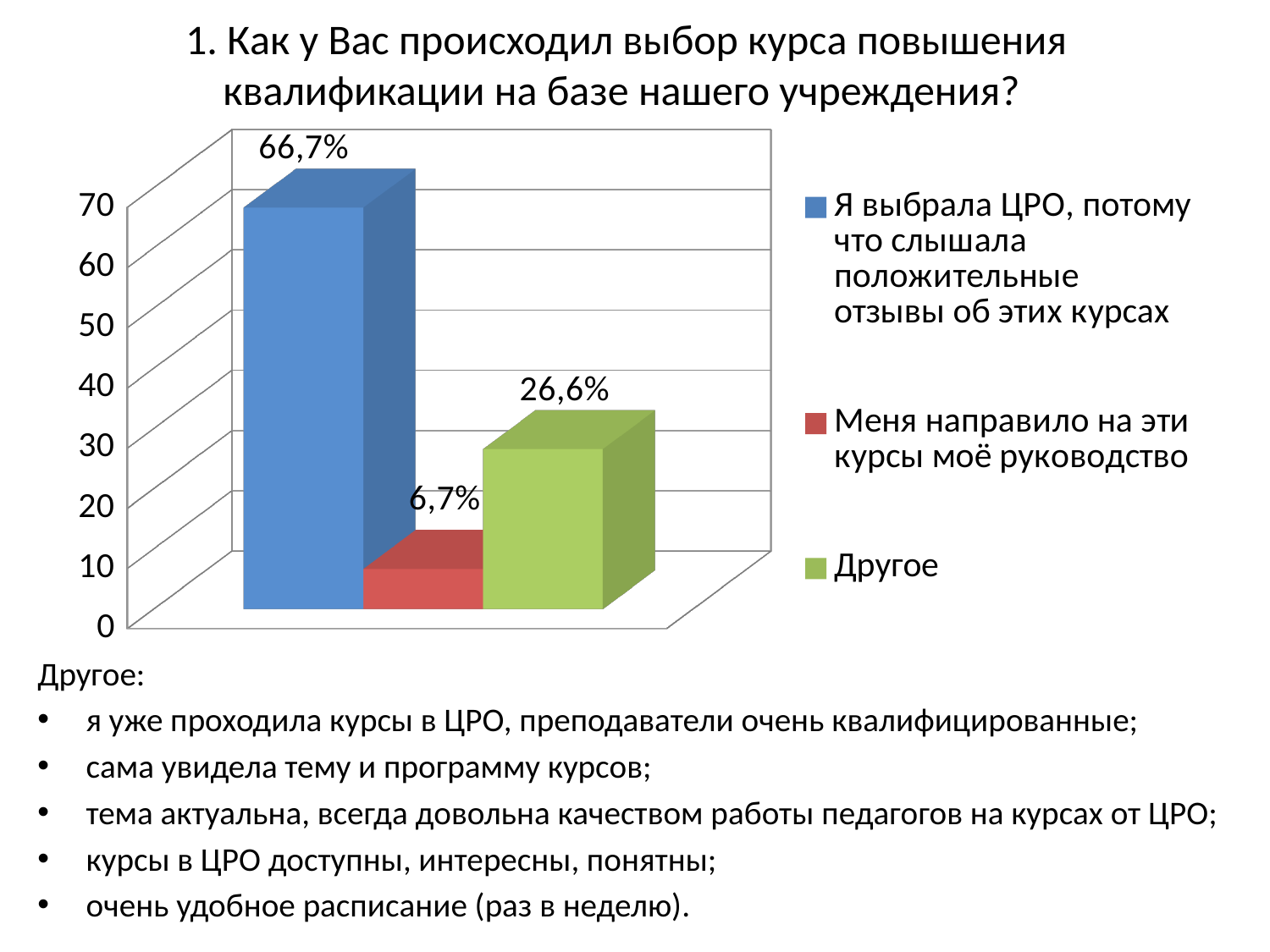
What value is shown for the series "Меня направило на эти курсы моё руководство"? 6,7% What colour is the bar for the series "Другое"? green What kind of chart is shown on the slide? bar chart What is the difference between the value for "Я выбрала ЦРО, потому что слышала положительные отзывы об этих курсах" and the value for "Другое"? 40,1% What value is shown for the series "Я выбрала ЦРО, потому что слышала положительные отзывы об этих курсах"? 66,7% What value is shown for the series "Другое"? 26,6% Is the value for "Другое" greater or less than 30? less Which is larger: the value for "Другое" or the value for "Меня направило на эти курсы моё руководство"? Другое Which series has the highest value? Я выбрала ЦРО, потому что слышала положительные отзывы об этих курсах How many series does the legend list? 3 What is the difference between the value for "Другое" and the value for "Меня направило на эти курсы моё руководство"? 19,9% Which series has the lowest value? Меня направило на эти курсы моё руководство